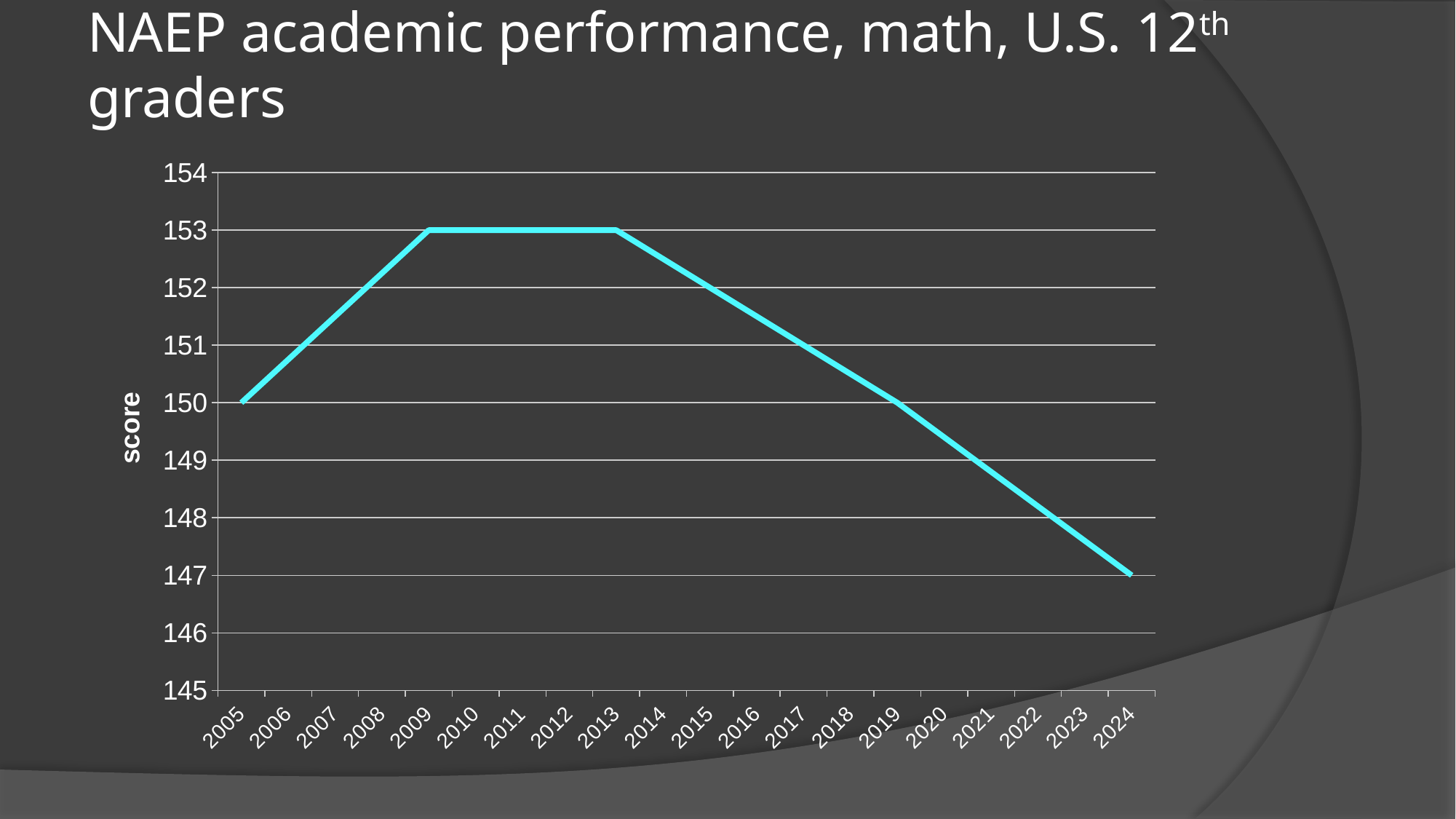
Which year has the higher score, 2005 or 2024? 2005 How many years are shown on the x axis? 20 What is the score for 2024? 147 What is the highest score reached on the chart? 153 What type of chart is shown on the slide? line chart What is the score for 2009? 153 Which year has the lowest score? 2024 What is the score for 2005? 150 What is the score for 2013? 153 What is the difference between the score in 2009 and the score in 2024? 6 Is the score for 2016 greater or less than 152? less What is the label on the vertical axis? score